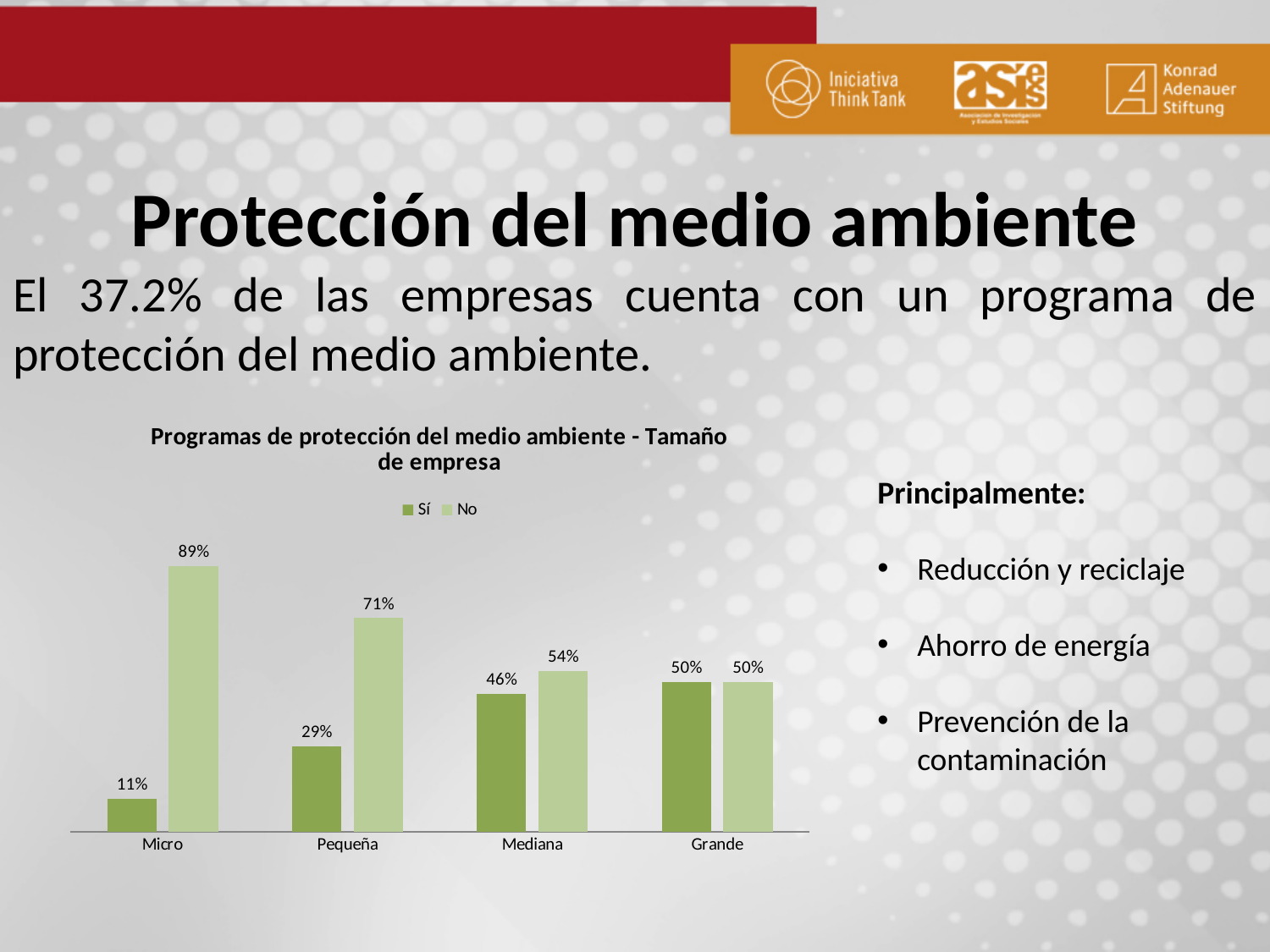
What is the difference between the 'No' and 'Sí' values for Micro? 78% Which company size has the lowest 'Sí' value? Micro Do the 'Sí' values rise or fall from Micro to Mediana? Rise Which is larger for Pequeña, the 'Sí' value or the 'No' value? No What kind of chart is shown on the slide? Bar chart How many company size categories are shown on the x axis? 4 How many series does the legend list? 2 What is the value of the 'Sí' series for Micro? 11% Which company size has the highest 'No' value? Micro What is the value of the 'No' series for Pequeña? 71% What is the value of the 'Sí' series for Mediana? 46% What is the value of the 'No' series for Grande? 50%